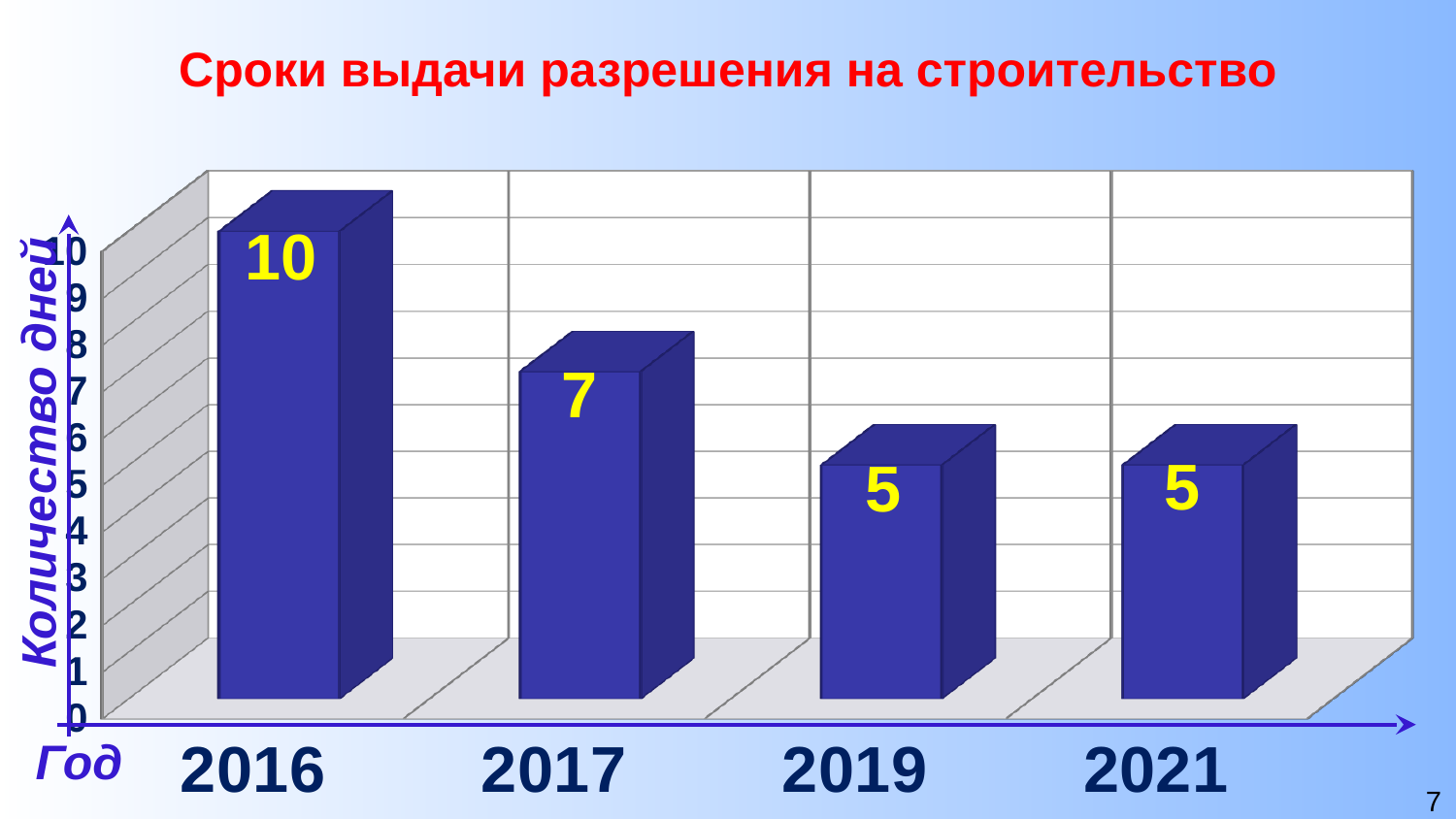
What is the value for 2021? 5 What kind of chart is this? bar chart Which is larger, the value for 2017 or the value for 2019? 2017 What is the difference between the values for 2016 and 2021? 5 Do the values rise or fall from 2016 to 2019? fall What is the title of the chart? Сроки выдачи разрешения на строительство What is the difference between the values for 2016 and 2017? 3 Which year has the highest value? 2016 What is the value for 2019? 5 What is the value for 2016? 10 How many years are shown on the x axis? 4 What is the value for 2017? 7